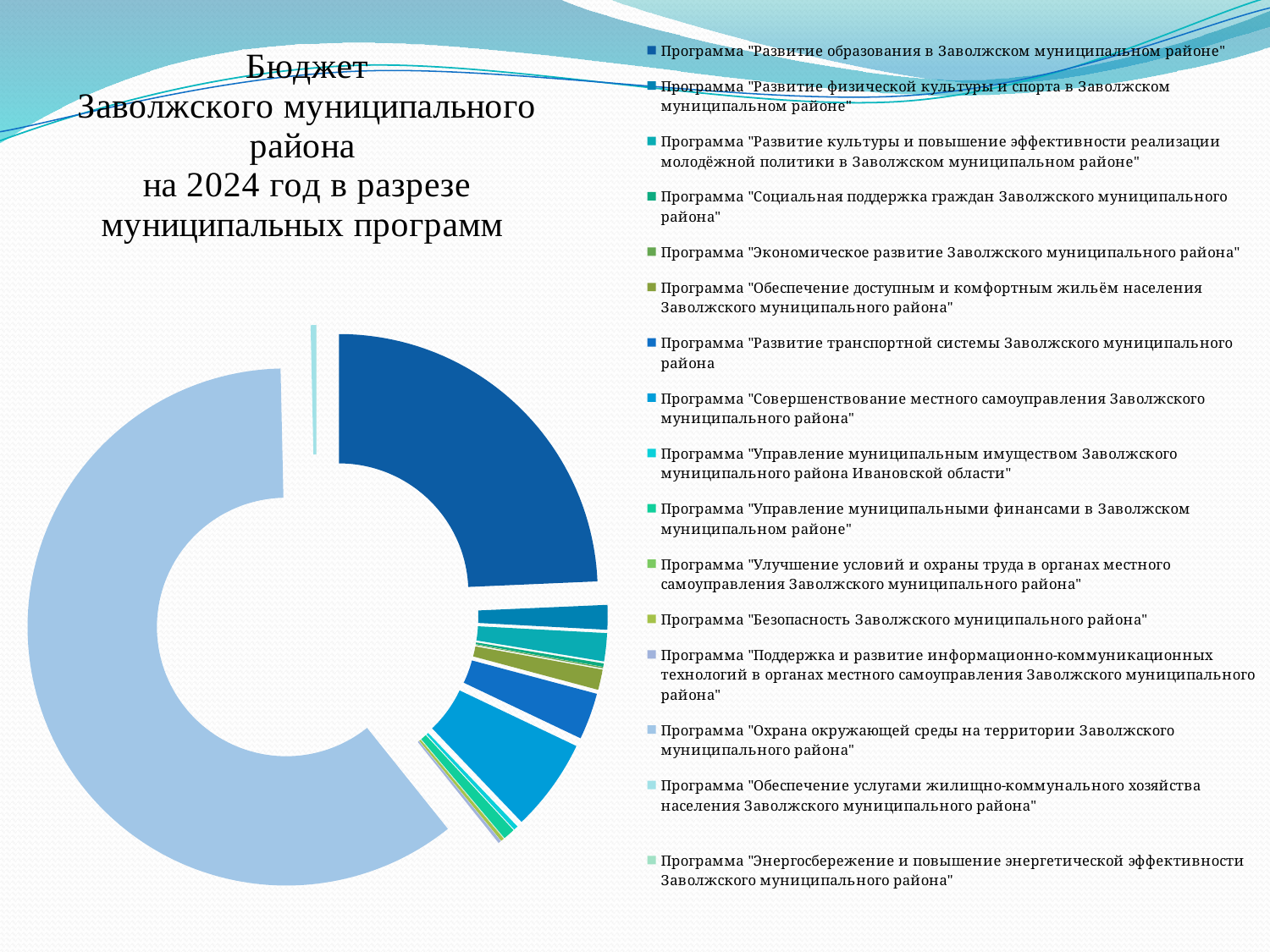
How many slices (categories) does the chart represent according to its legend? 16 What is the title of the chart on the slide? Бюджет Заволжского муниципального района на 2024 год в разрезе муниципальных программ Is the largest slice of the doughnut greater or less than half of the whole? greater What kind of chart is shown on the slide? Doughnut (pie) chart How many programmes does the chart legend list? 16 Is the dark blue slice at the top right of the doughnut greater or less than half of the whole? less Which is larger: the dark blue slice at the top right of the doughnut or the teal slice below it? The dark blue slice Which programme is listed first in the chart legend? Программа "Развитие образования в Заволжском муниципальном районе"